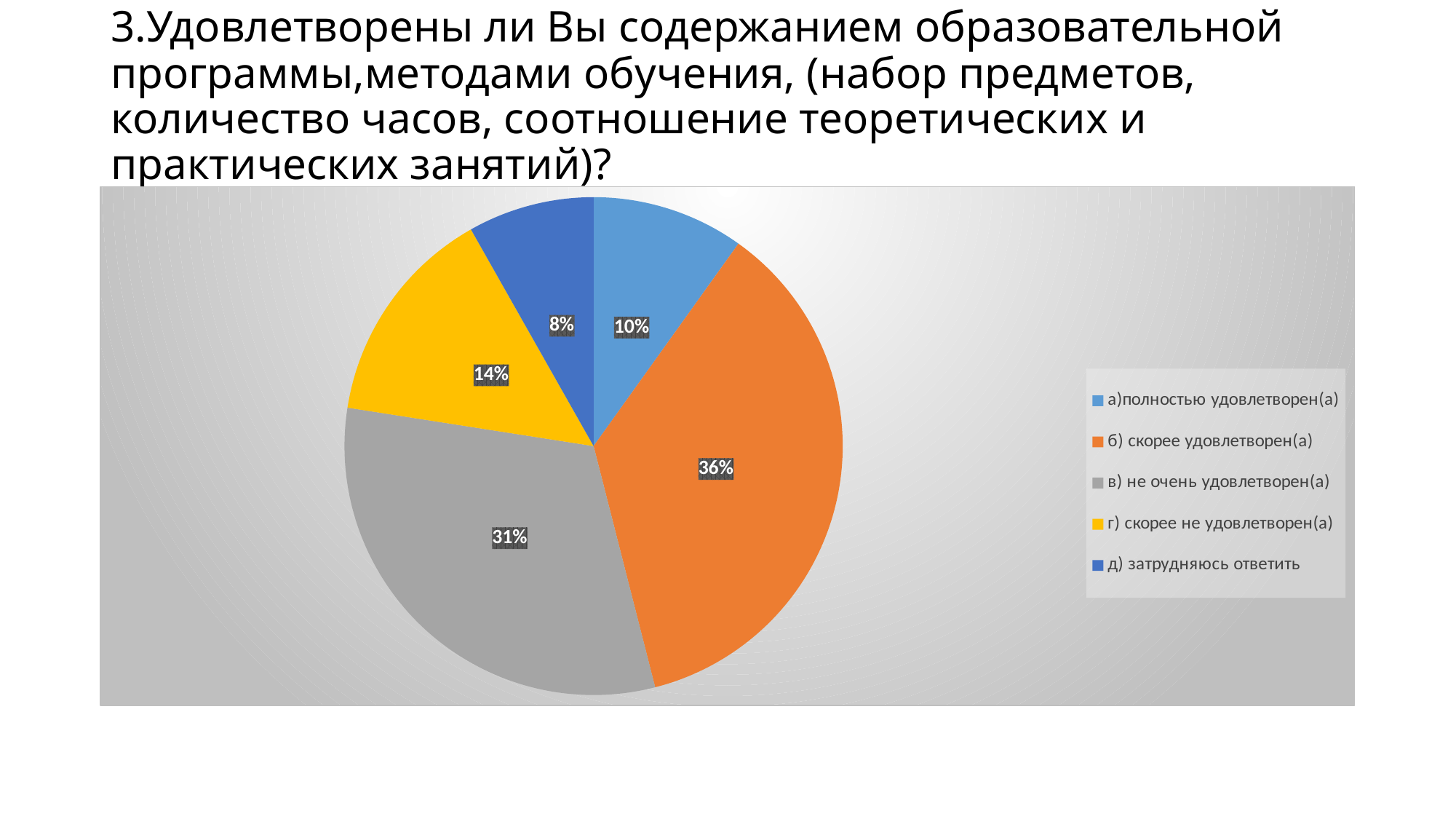
What share of the pie is labelled for "б) скорее удовлетворен(а)"? 36% Which is larger: the slice for "г) скорее не удовлетворен(а)" or the slice for "а)полностью удовлетворен(а)"? г) скорее не удовлетворен(а) Which category has the largest slice of the pie? б) скорее удовлетворен(а) What share of the pie is labelled for "в) не очень удовлетворен(а)"? 31% Which category has the smallest slice of the pie? д) затрудняюсь ответить What kind of chart is shown on the slide? pie chart What share of the pie is labelled for "а)полностью удовлетворен(а)"? 10% What share of the pie is labelled for "д) затрудняюсь ответить"? 8% How many categories does the legend list? 5 What share of the pie is labelled for "г) скорее не удовлетворен(а)"? 14% What colour is the slice for "г) скорее не удовлетворен(а)"? yellow What is the difference in percentage points between "б) скорее удовлетворен(а)" and "в) не очень удовлетворен(а)"? 5